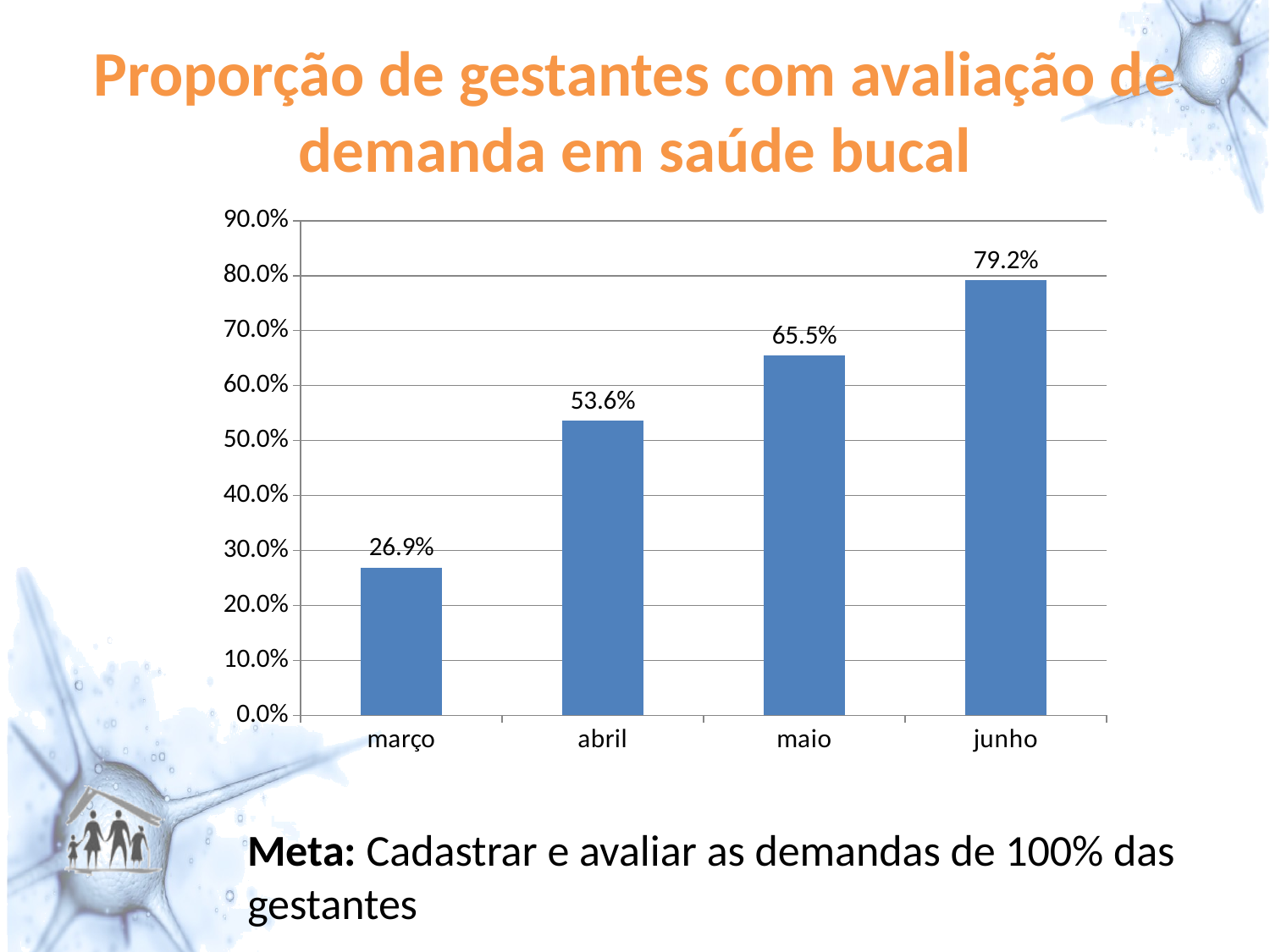
What is the value for março? 26.9% What is the difference between the values for maio and abril? 11.9% Which month has the lowest value? março Which month has the highest value? junho What kind of chart is shown on the slide? bar chart Do the values rise or fall from março to junho? rise Which is larger, the value for abril or the value for maio? maio What is the value for junho? 79.2% What is the value for maio? 65.5% What is the difference between the values for junho and março? 52.3% How many months are shown on the x axis? 4 What is the value for abril? 53.6%